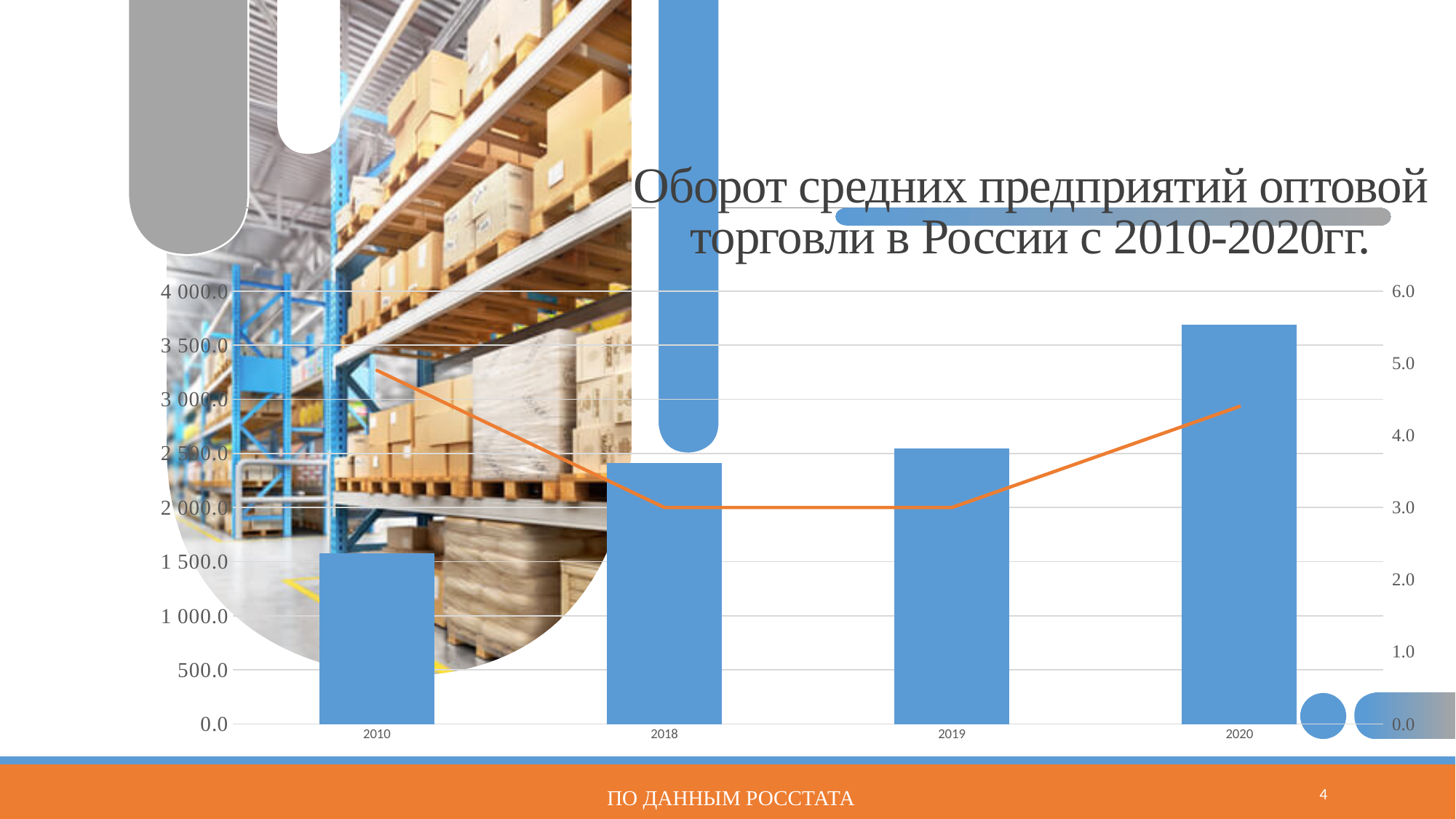
Which year has the tallest bar in the chart? 2020 Is the bar value for 2020 greater or less than 3 500.0 on the left axis? greater Do the bar values rise or fall from 2010 to 2020? rise Is the bar value for 2019 greater or less than 2 000.0 on the left axis? greater What is the title of the chart on the slide? Оборот средних предприятий оптовой торговли в России с 2010-2020гг. Which year has the shortest bar in the chart? 2010 Is the bar value for 2010 greater or less than 2 000.0 on the left axis? less What kind of chart is shown on the slide? A combined bar and line chart In which year does the orange line reach its highest point? 2010 How many years are shown on the x axis of the chart? 4 Which bar is taller, 2019 or 2020? 2020